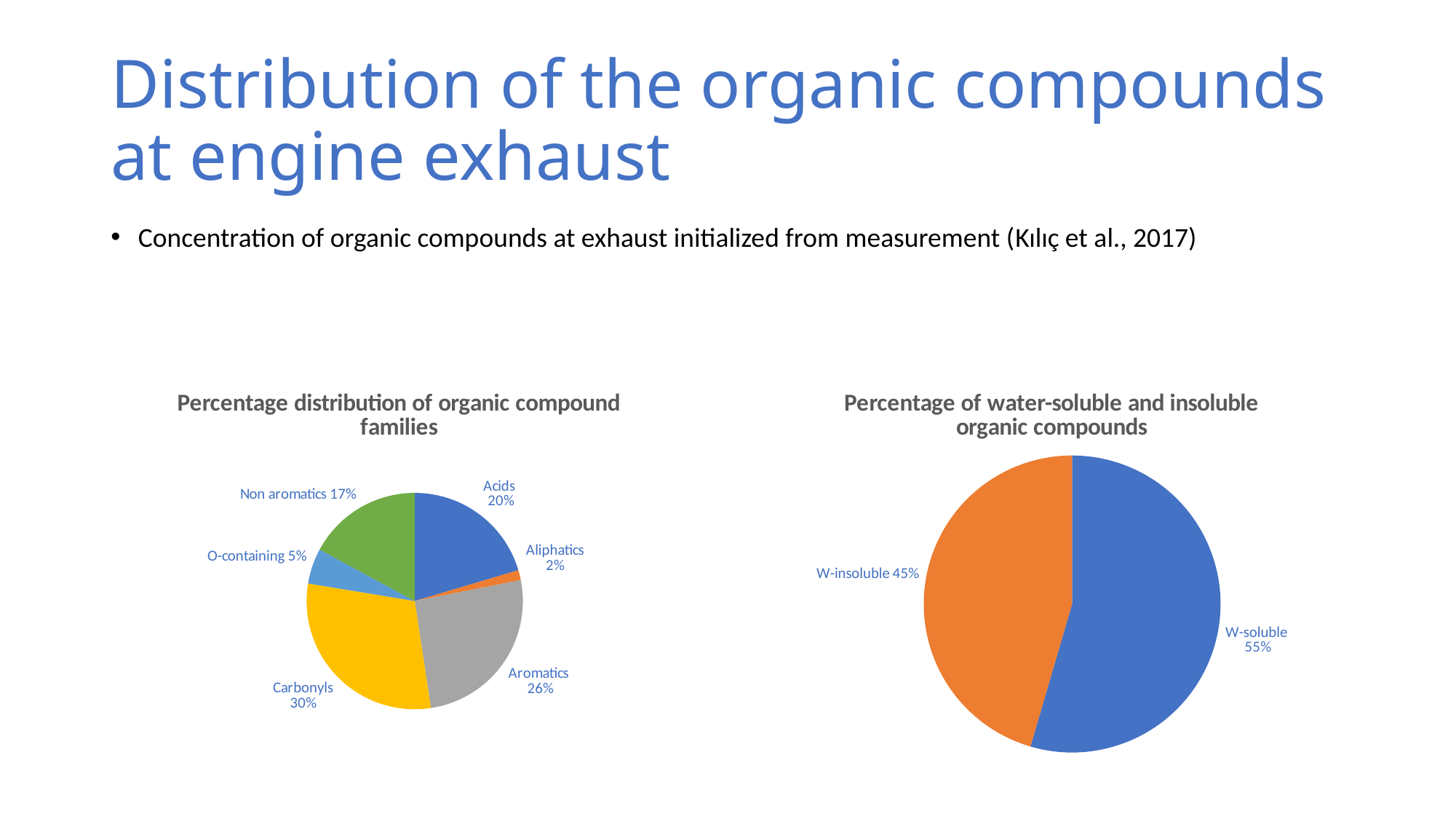
In the 'Percentage distribution of organic compound families' chart, which compound family has the smallest share? Aliphatics In the 'Percentage distribution of organic compound families' chart, what is the difference between the shares of Acids and Non aromatics? 3% In the 'Percentage of water-soluble and insoluble organic compounds' chart, what colour is the W-insoluble slice? Orange In the 'Percentage of water-soluble and insoluble organic compounds' chart, what is the share of W-insoluble compounds? 45% What kind of chart is the 'Percentage distribution of organic compound families' chart? Pie chart In the 'Percentage distribution of organic compound families' chart, which compound family has the largest share? Carbonyls In the 'Percentage distribution of organic compound families' chart, what share do Aromatics have? 26% In the 'Percentage distribution of organic compound families' chart, how many compound families are shown? 6 In the 'Percentage distribution of organic compound families' chart, what share do Carbonyls have? 30% In the 'Percentage of water-soluble and insoluble organic compounds' chart, what is the difference between the W-soluble and W-insoluble shares? 10% In the 'Percentage distribution of organic compound families' chart, which is larger, the share of Acids or the share of O-containing compounds? Acids In the 'Percentage of water-soluble and insoluble organic compounds' chart, what is the share of W-soluble compounds? 55%